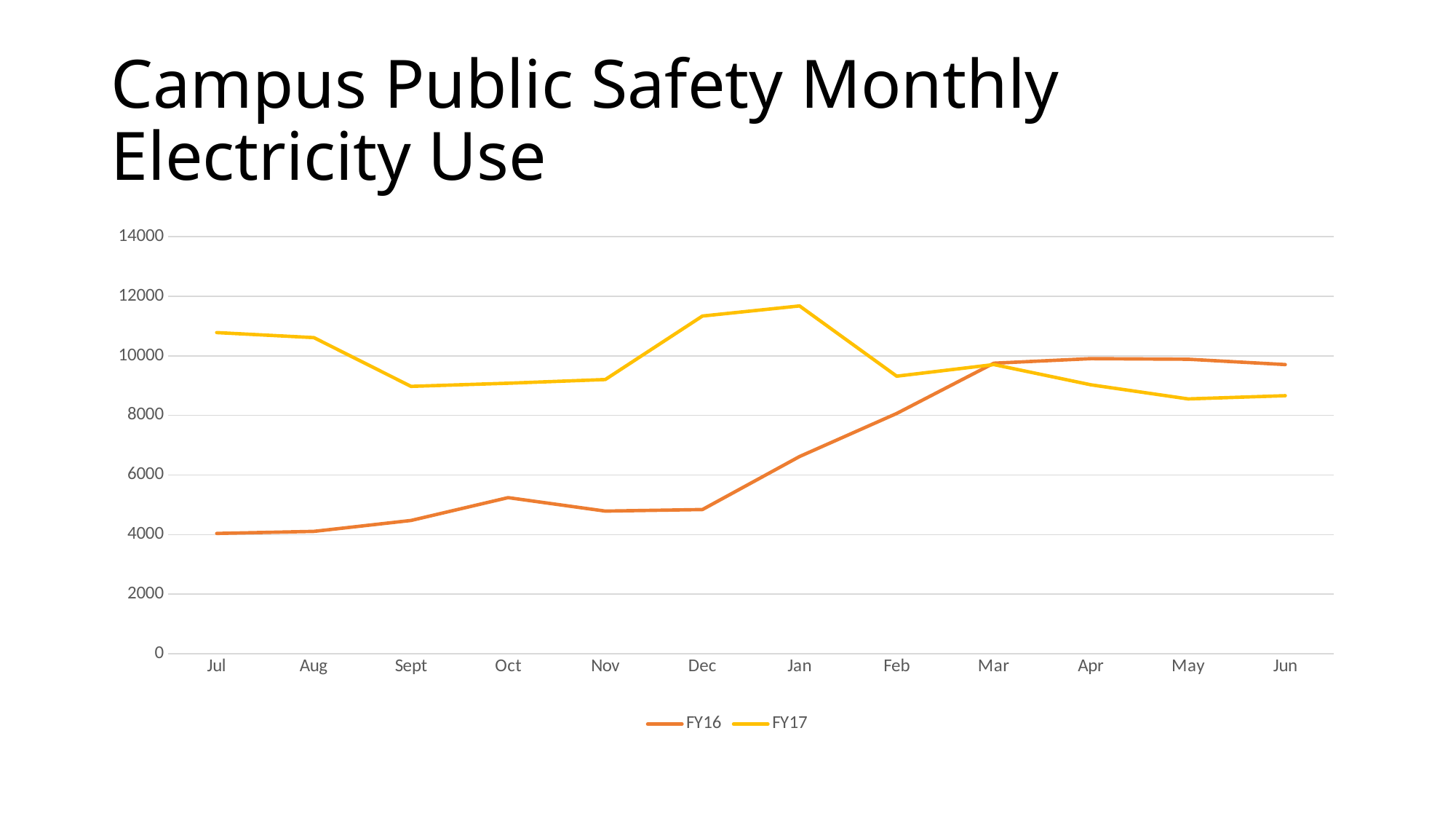
How many months are plotted along the x axis? 12 Is the FY16 value for Jul greater or less than 6000? less In Dec, which series has the larger value, FY16 or FY17? FY17 What kind of chart is shown on the slide? line chart How many series does the legend list? 2 In Apr, which series has the larger value, FY16 or FY17? FY16 Is the FY16 value for Jan greater or less than 6000? greater What is the title of the chart on the slide? Campus Public Safety Monthly Electricity Use In which month does the FY17 series reach its highest value? Jan Is the FY17 value for Jan greater or less than 10000? greater Does the FY16 series rise or fall from Dec to Mar? rise